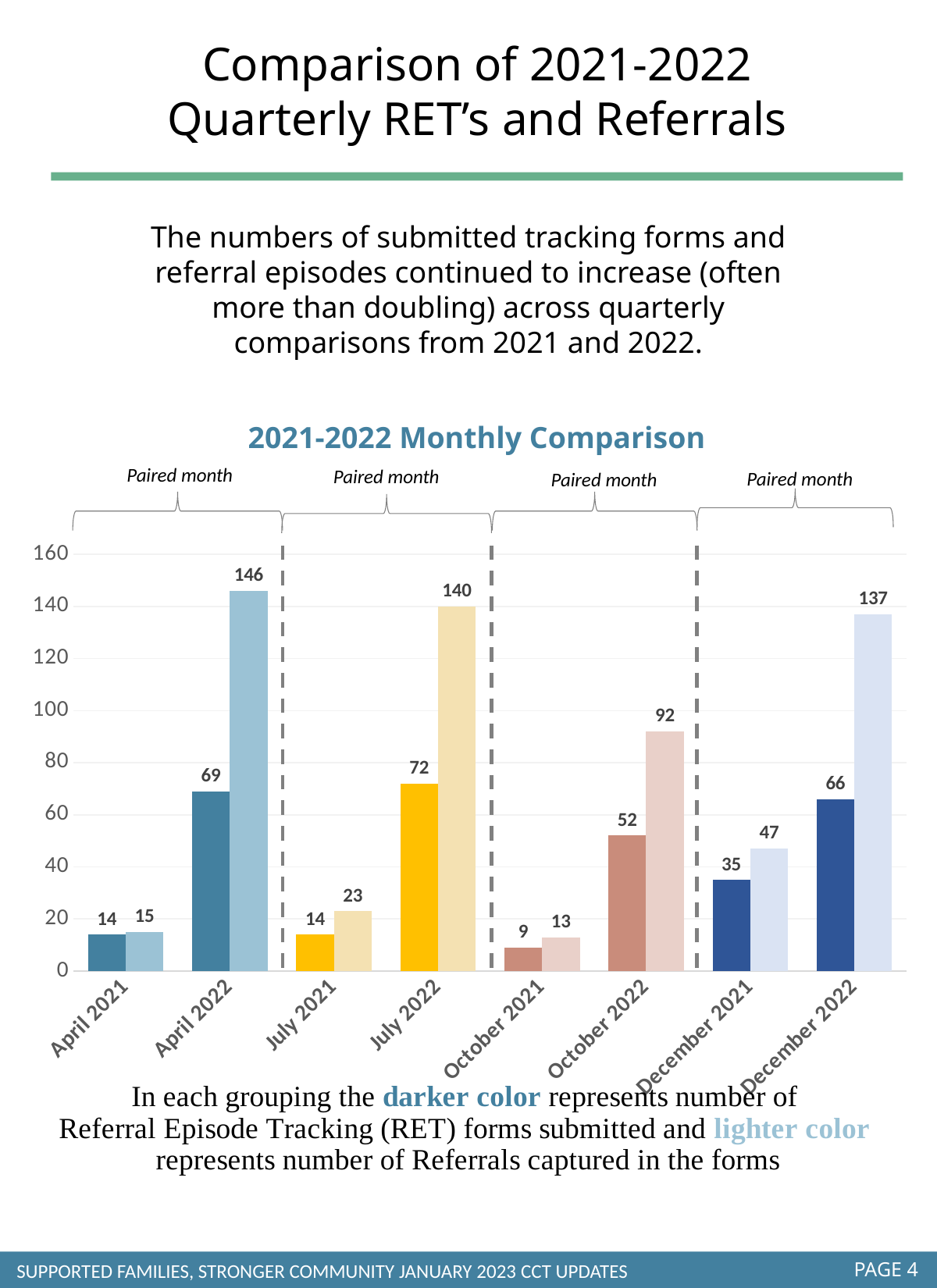
What is the number of RET forms (darker bar) for October 2021? 9 What is the title of the chart? 2021-2022 Monthly Comparison Which month has the highest Referrals (lighter bar) value? April 2022 What is the difference between the Referrals values for July 2022 and July 2021? 117 What type of chart is the 2021-2022 Monthly Comparison? Bar chart What is the number of Referrals (lighter bar) for December 2021? 47 What is the number of Referrals (lighter bar) for April 2022? 146 Which month has the lowest RET forms (darker bar) value? October 2021 How many month categories are shown on the x axis of the chart? 8 Is the Referrals value for October 2022 greater or less than 100? less What is the number of RET forms (darker bar) for July 2022? 72 Which is larger: the RET forms value for December 2022 or for April 2022? April 2022